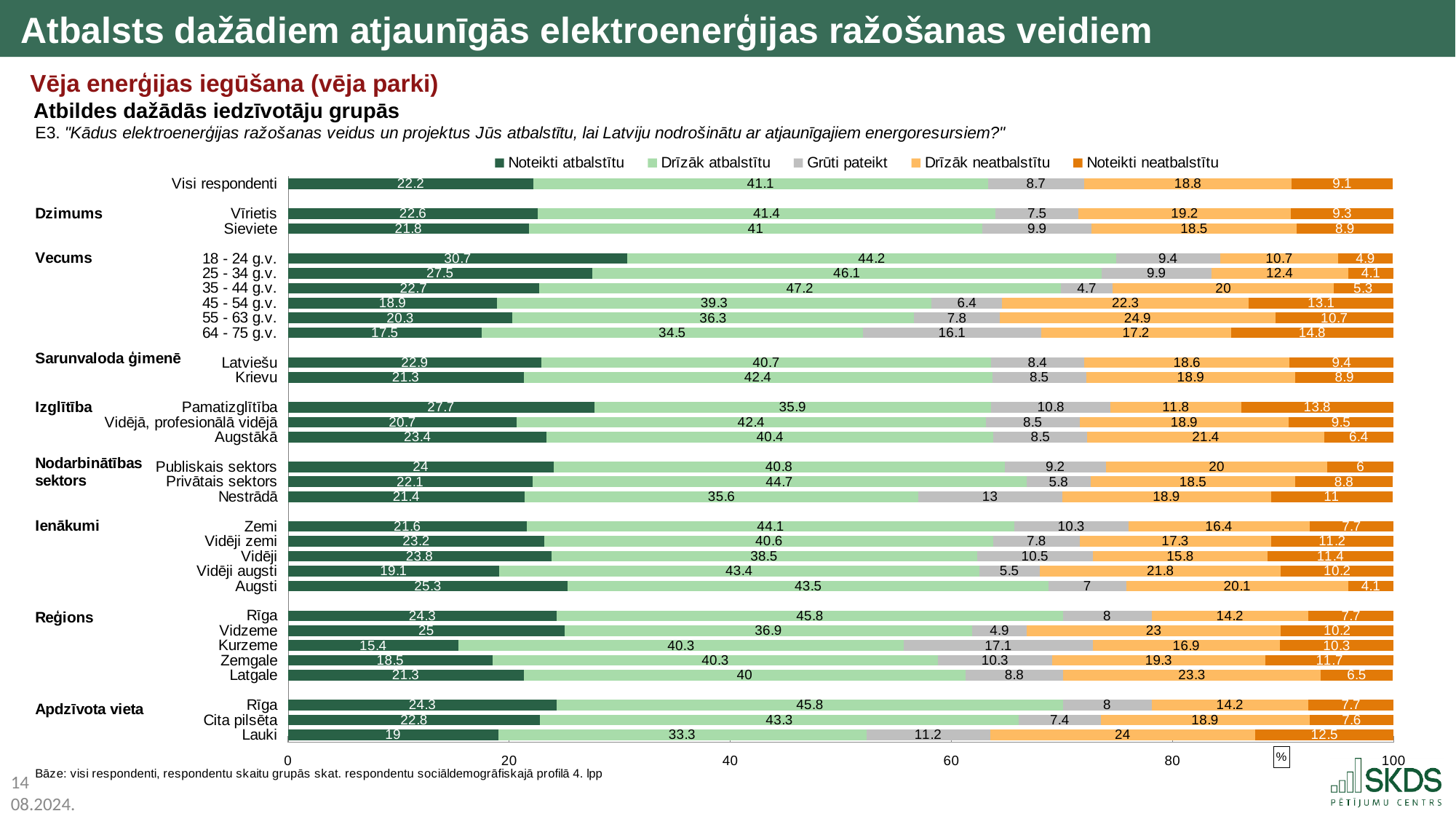
What is the "Drīzāk atbalstītu" value for the "18 - 24 g.v." age group? 44.2 What kind of chart is shown on the slide? Stacked bar chart Which has a larger "Noteikti neatbalstītu" value: "64 - 75 g.v." or "18 - 24 g.v."? 64 - 75 g.v. What is the difference between the "Noteikti atbalstītu" values for "Vīrietis" and "Sieviete"? 0.8 What is the "Noteikti atbalstītu" value for "Visi respondenti"? 22.2 Among the regions (Reģions), which has the lowest "Noteikti atbalstītu" value? Kurzeme How many series does the legend list? 5 What is the "Grūti pateikt" value for "Lauki"? 11.2 Among the education groups (Izglītība), which has the highest "Noteikti neatbalstītu" value? Pamatizglītība What is the total of the stacked bar for "Visi respondenti"? 99.9 Among the age groups (Vecums), which has the highest "Noteikti atbalstītu" value? 18 - 24 g.v. What is the "Drīzāk neatbalstītu" value for "Latgale"? 23.3